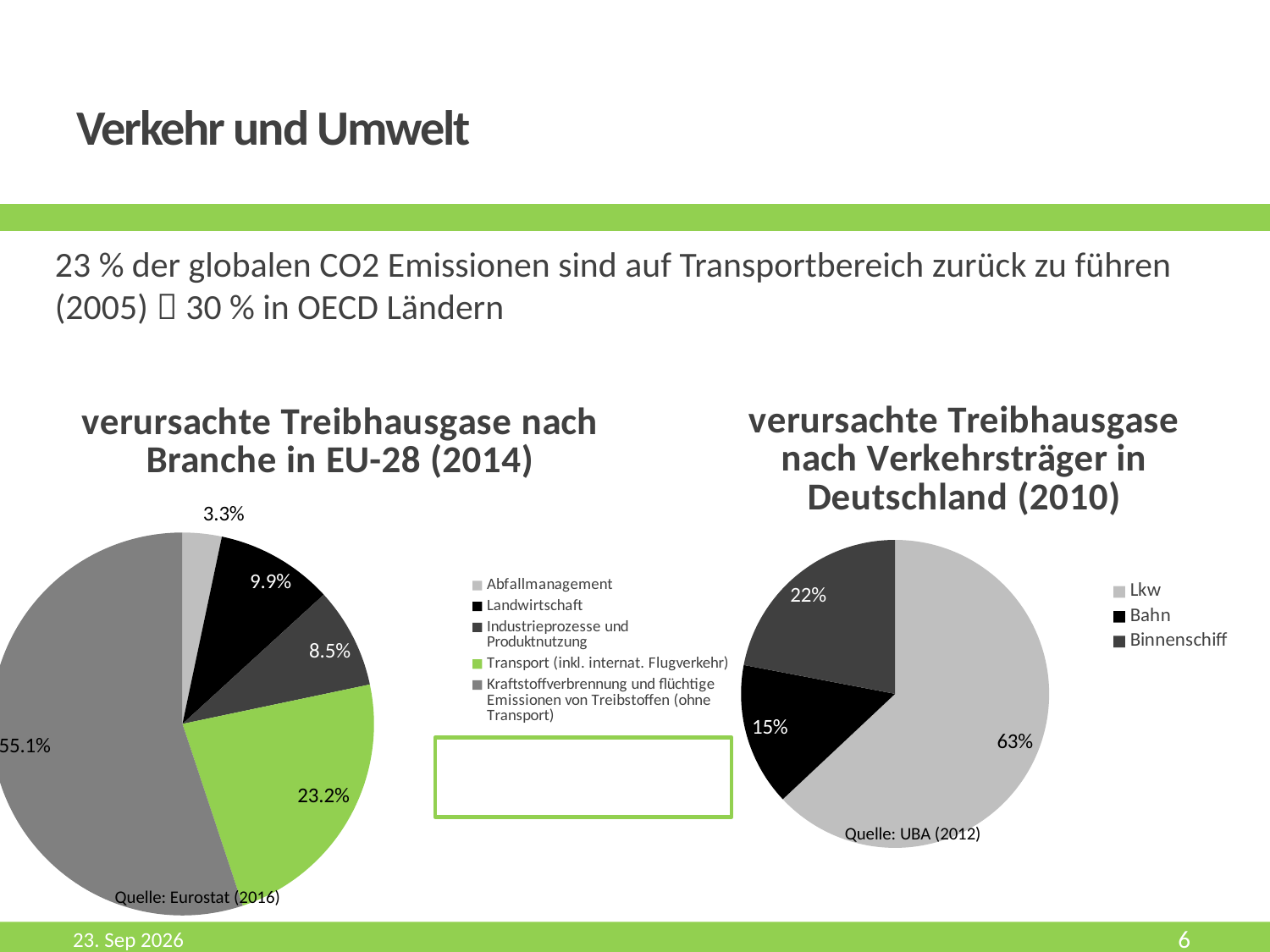
In the chart 'verursachte Treibhausgase nach Branche in EU-28 (2014)', which category has the smallest share? Abfallmanagement In the chart 'verursachte Treibhausgase nach Branche in EU-28 (2014)', what is the difference between the shares of Landwirtschaft and Industrieprozesse und Produktnutzung? 1.4% In the chart 'verursachte Treibhausgase nach Verkehrsträger in Deutschland (2010)', which category has the smallest share? Bahn In the chart 'verursachte Treibhausgase nach Verkehrsträger in Deutschland (2010)', which is larger, Bahn or Binnenschiff? Binnenschiff In the chart 'verursachte Treibhausgase nach Branche in EU-28 (2014)', which category has the largest share? Kraftstoffverbrennung und flüchtige Emissionen von Treibstoffen (ohne Transport) In the chart 'verursachte Treibhausgase nach Branche in EU-28 (2014)', what share does Transport (inkl. internat. Flugverkehr) have? 23.2% In the chart 'verursachte Treibhausgase nach Branche in EU-28 (2014)', how many categories does the legend list? 5 In the chart 'verursachte Treibhausgase nach Branche in EU-28 (2014)', what share does Landwirtschaft have? 9.9% In the chart 'verursachte Treibhausgase nach Verkehrsträger in Deutschland (2010)', what share does Binnenschiff have? 22% In the chart 'verursachte Treibhausgase nach Verkehrsträger in Deutschland (2010)', what share does Lkw have? 63% In the chart 'verursachte Treibhausgase nach Verkehrsträger in Deutschland (2010)', what is the difference between the shares of Lkw and Bahn? 48% What kind of chart is 'verursachte Treibhausgase nach Verkehrsträger in Deutschland (2010)'? Pie chart